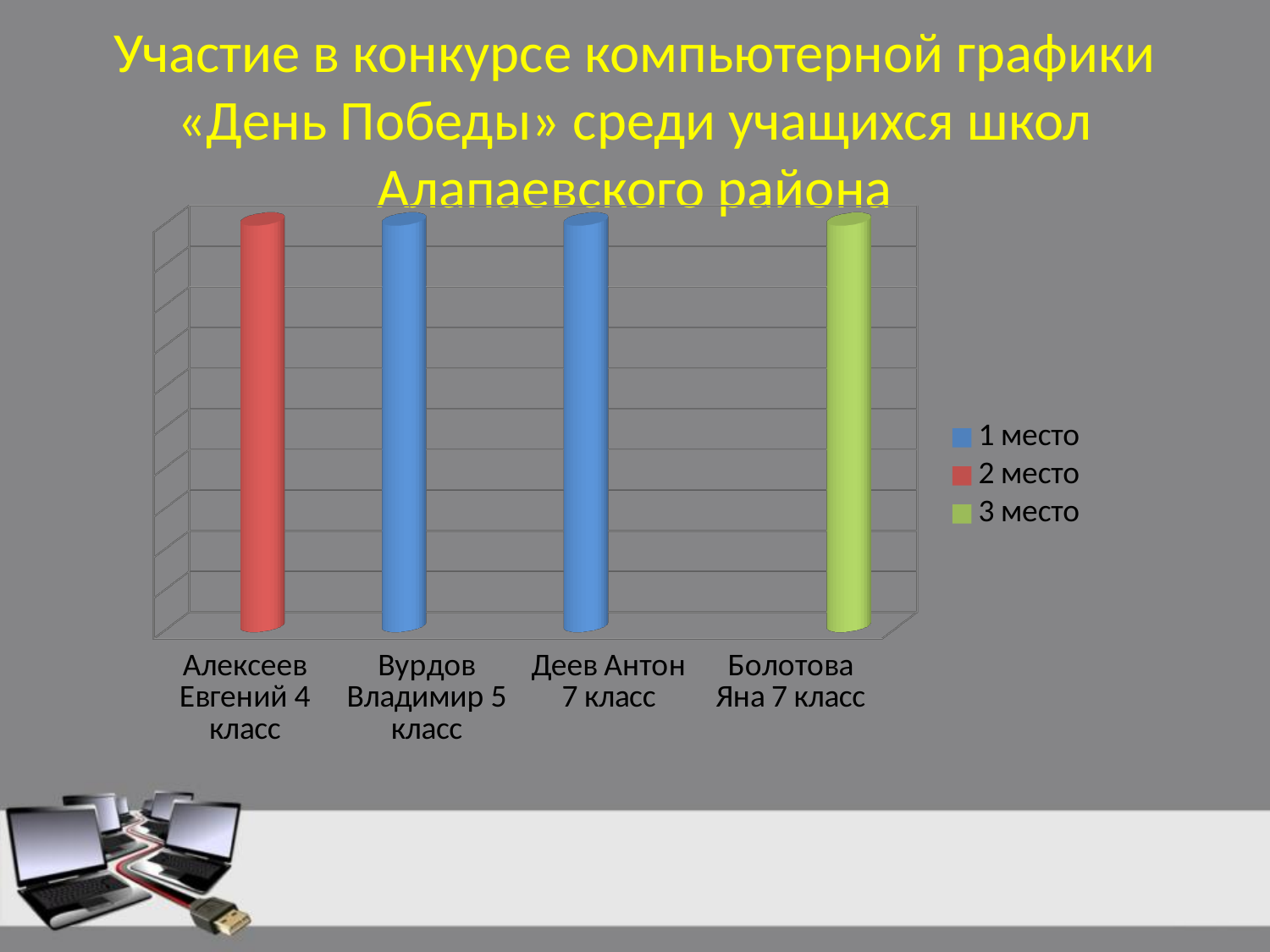
Which two students have blue bars (1 место) in the chart? Вурдов Владимир 5 класс and Деев Антон 7 класс Which legend entry does the red bar (Алексеев Евгений 4 класс) correspond to? 2 место How many series does the chart's legend list? 3 What are the three entries in the chart's legend? 1 место, 2 место, 3 место Which place (место) does the bar for Деев Антон 7 класс represent according to the legend colours? 1 место How many categories (students) are shown on the x axis of the chart? 4 What kind of chart is shown on the slide? bar chart Which place (место) does the bar for Болотова Яна 7 класс represent according to the legend colours? 3 место Which student's bar is coloured green in the chart? Болотова Яна 7 класс What is the label of the first category on the left of the x axis? Алексеев Евгений 4 класс How many students in the chart are in 7 класс? 2